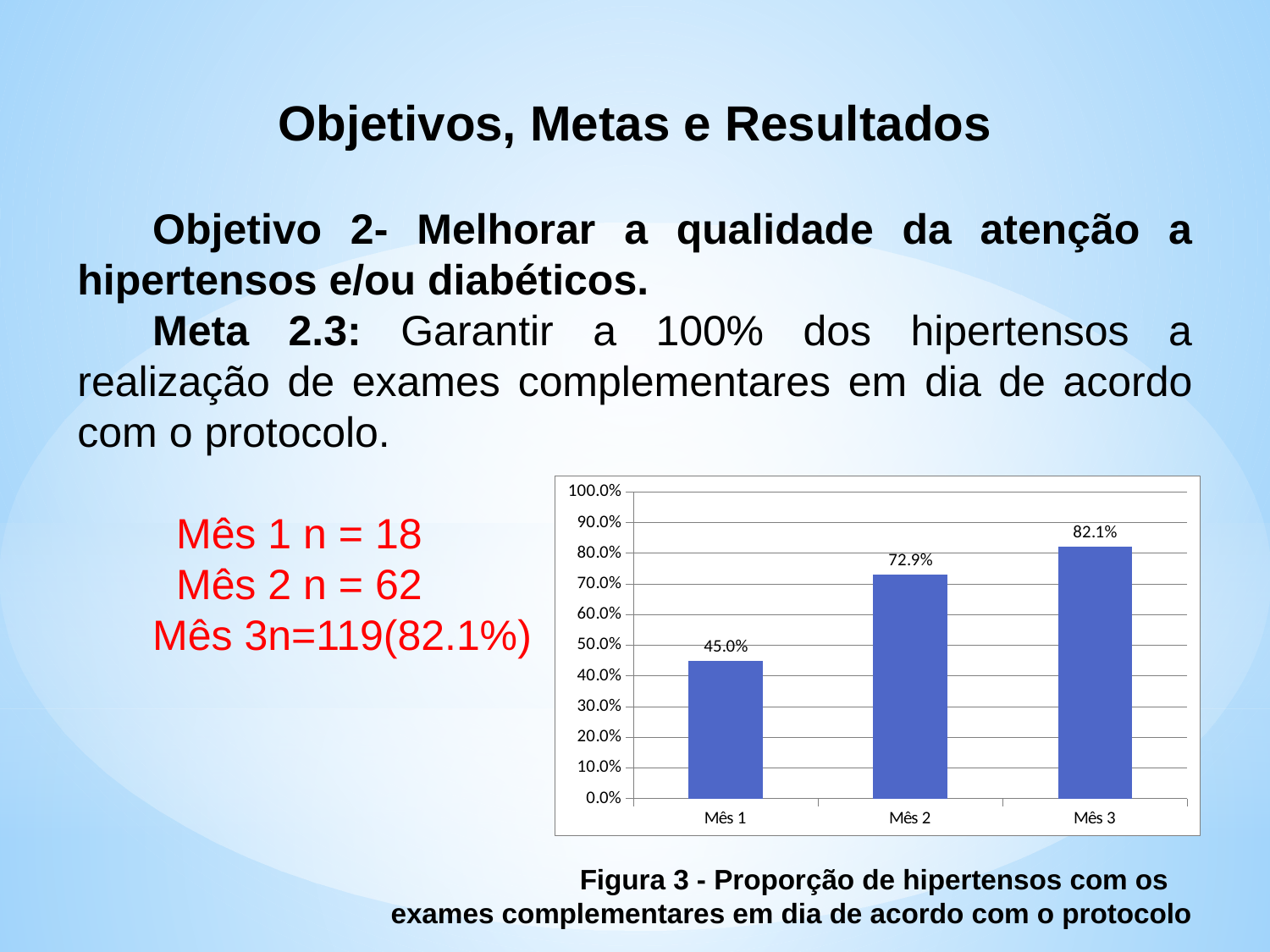
Do the values rise or fall from Mês 1 to Mês 3? rise What is the value for Mês 2? 72.9% Which month has the highest value? Mês 3 What kind of chart is shown? bar chart How many months are shown on the x axis? 3 Which month has the lowest value? Mês 1 Is the value for Mês 1 greater or less than 50.0%? less Which is larger, the value for Mês 2 or the value for Mês 3? Mês 3 What is the difference between the values for Mês 2 and Mês 1? 27.9% What is the value for Mês 1? 45.0% What is the value for Mês 3? 82.1% What is the difference between the values for Mês 3 and Mês 1? 37.1%